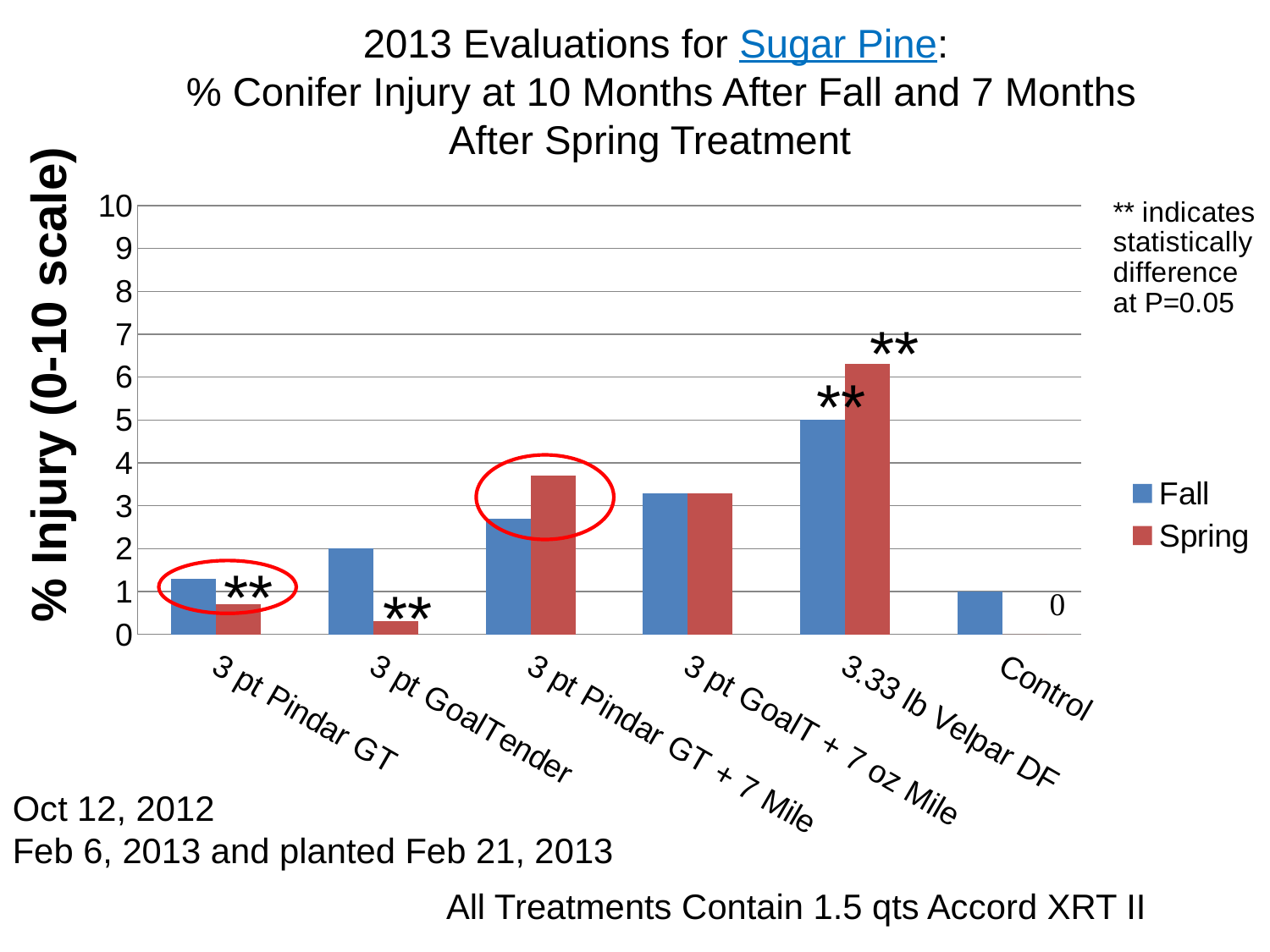
For 3.33 lb Velpar DF, which is larger, the Fall value or the Spring value? Spring What are the two series named in the legend? Fall and Spring How many treatment categories are shown on the x axis? 6 Is the Spring value for 3 pt GoalTender greater or less than 1? less Is the Spring value for 3.33 lb Velpar DF greater or less than 6? greater Which category has the lowest Spring value? Control How many series does the legend list? 2 What is the Spring value for Control? 0 Which category has the highest Spring value? 3.33 lb Velpar DF What kind of chart is shown on the slide? bar chart What is the title of the y axis? % Injury (0-10 scale) For 3 pt GoalTender, which is larger, the Fall value or the Spring value? Fall